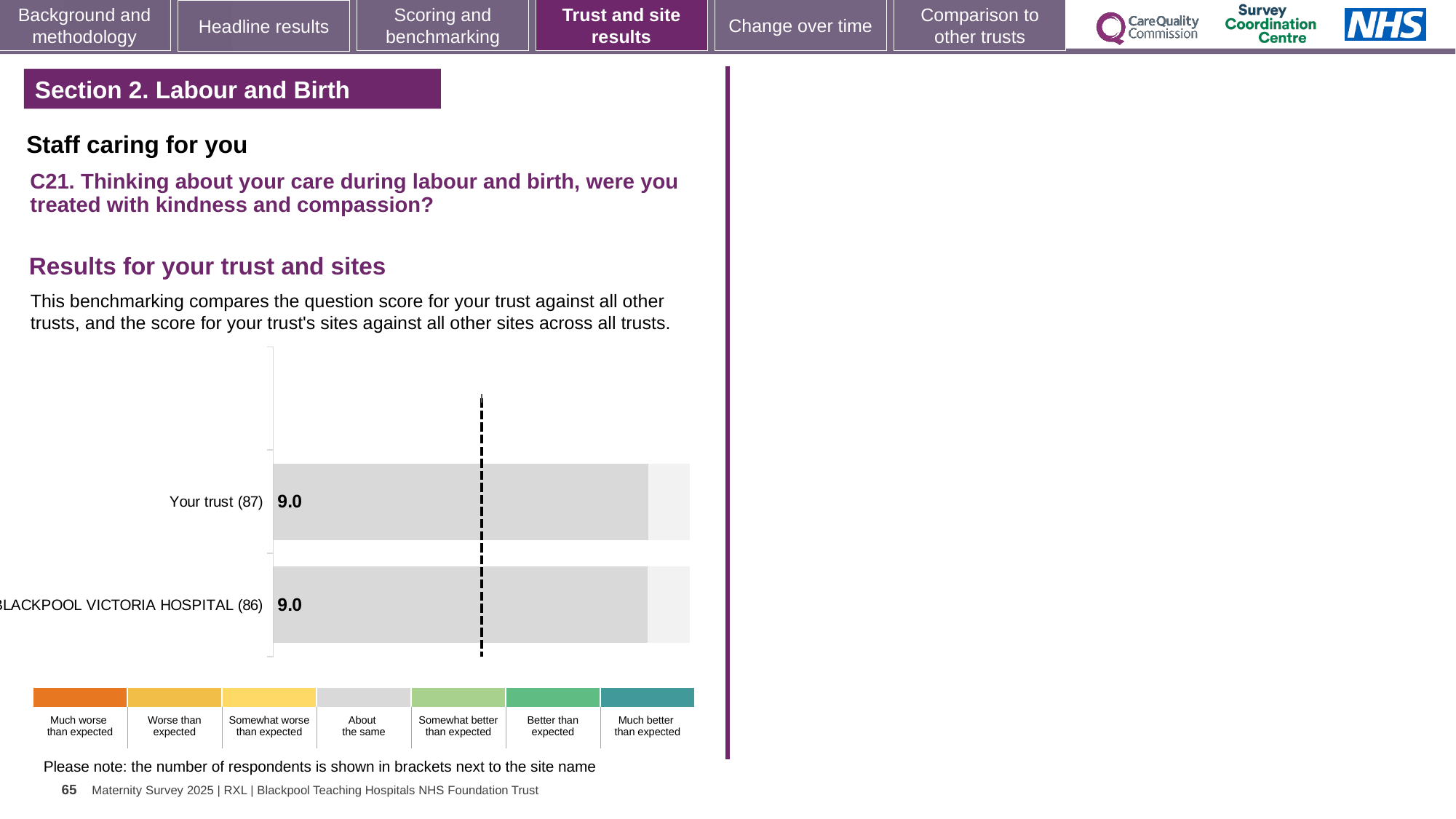
What is the difference between the score for Your trust (87) and the score for BLACKPOOL VICTORIA HOSPITAL (86)? 0.0 Which benchmarking category does the grey colour of the bars correspond to in the colour key? About the same How many respondents are shown in brackets for Your trust? 87 What kind of chart is shown on the slide? Bar chart What is the score shown for BLACKPOOL VICTORIA HOSPITAL (86)? 9.0 How many bars are plotted in the chart? 2 What is the score shown for Your trust (87)? 9.0